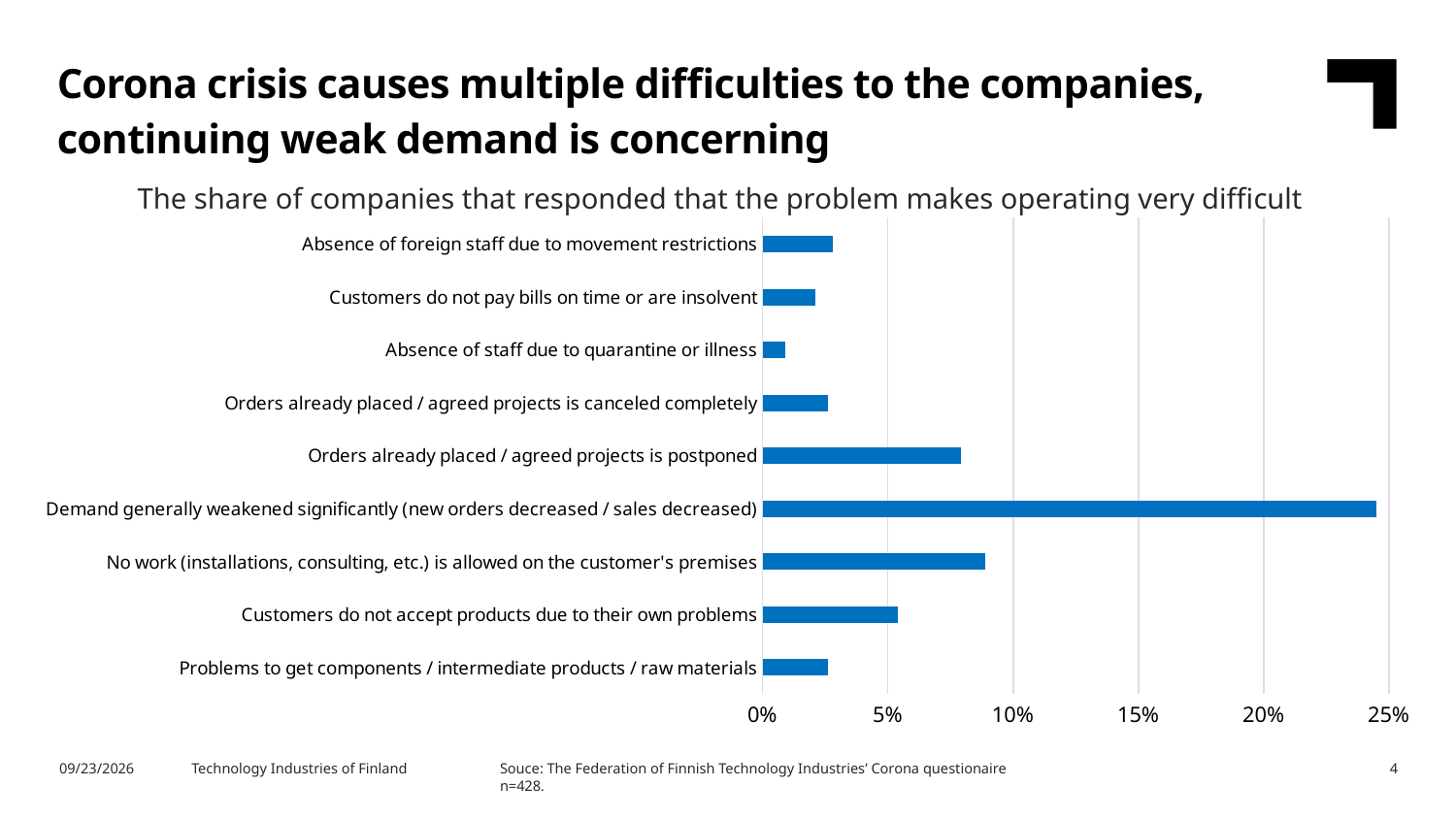
Is the value for 'Problems to get components / intermediate products / raw materials' greater or less than 5%? less Is the value for 'No work (installations, consulting, etc.) is allowed on the customer's premises' greater or less than 5%? greater Which is larger: the value for 'Orders already placed / agreed projects is postponed' or the value for 'Customers do not accept products due to their own problems'? Orders already placed / agreed projects is postponed Is the value for 'Demand generally weakened significantly (new orders decreased / sales decreased)' greater or less than 20%? greater Which is larger: the value for 'Absence of foreign staff due to movement restrictions' or the value for 'Absence of staff due to quarantine or illness'? Absence of foreign staff due to movement restrictions Which problem has the highest share of companies saying it makes operating very difficult? Demand generally weakened significantly (new orders decreased / sales decreased) What kind of chart is shown on the slide? Bar chart Which problem has the lowest share of companies saying it makes operating very difficult? Absence of staff due to quarantine or illness How many categories (problems) are plotted in the chart? 9 What is the title of the chart? The share of companies that responded that the problem makes operating very difficult